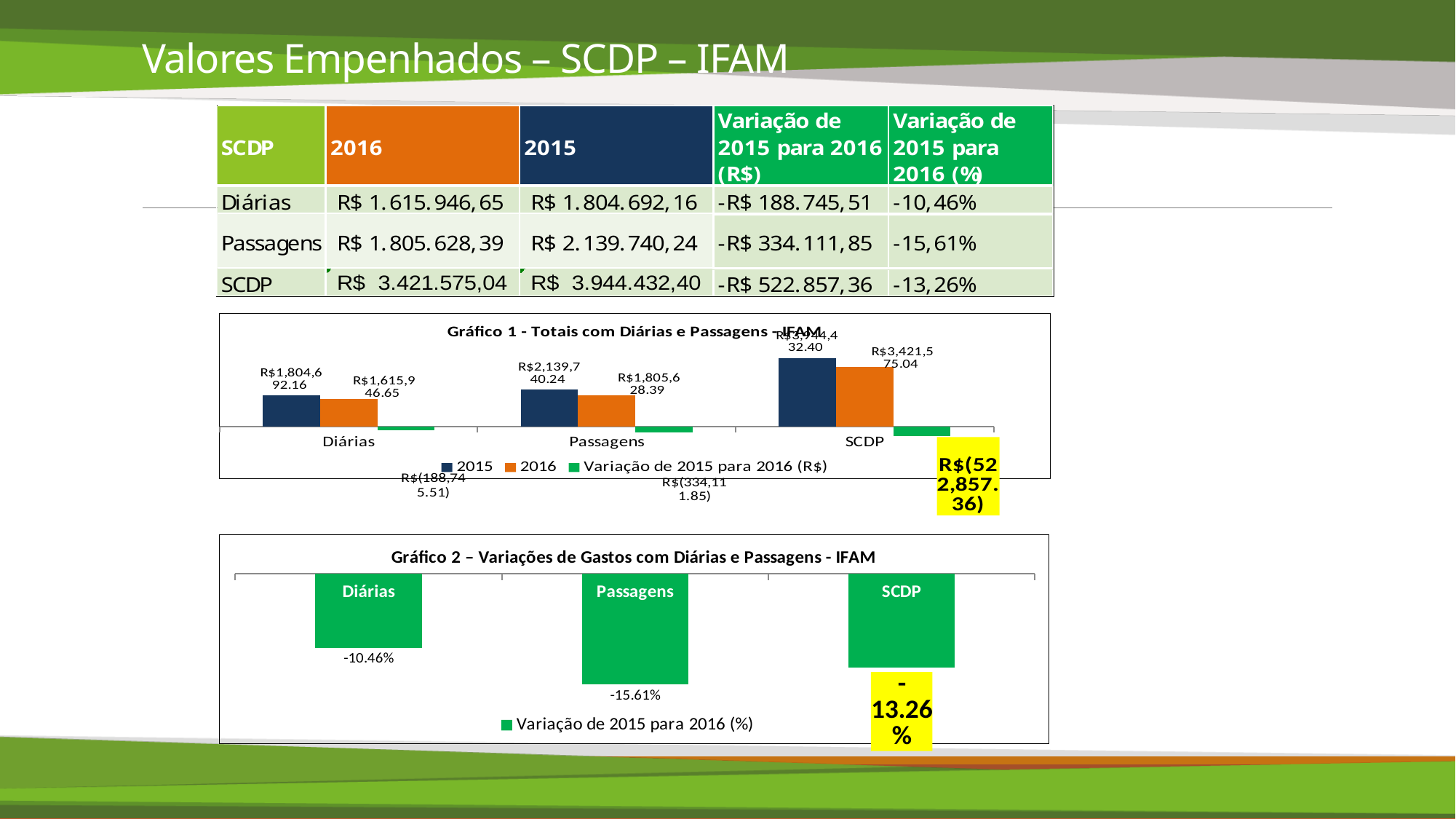
In Gráfico 1, what is the 2015 value for Passagens? R$2,139,740.24 In Gráfico 2, what is the value for Passagens? -15.61% How many categories are shown in Gráfico 2? 3 What kind of chart is Gráfico 2? Bar chart In Gráfico 1, which category has the lowest 2015 value? Diárias In Gráfico 1, which category has the highest 2016 value? SCDP In Gráfico 1, what is the Variação de 2015 para 2016 (R$) value for Passagens? R$(334,111.85) In Gráfico 1, what is the 2016 value for SCDP? R$3,421,575.04 In Gráfico 2, which category has the smallest percentage decrease (value closest to zero)? Diárias In Gráfico 1, what is the 2016 value for Diárias? R$1,615,946.65 How many series does the legend of Gráfico 1 list? 3 In Gráfico 1, which is larger for Passagens: the 2015 value or the 2016 value? 2015